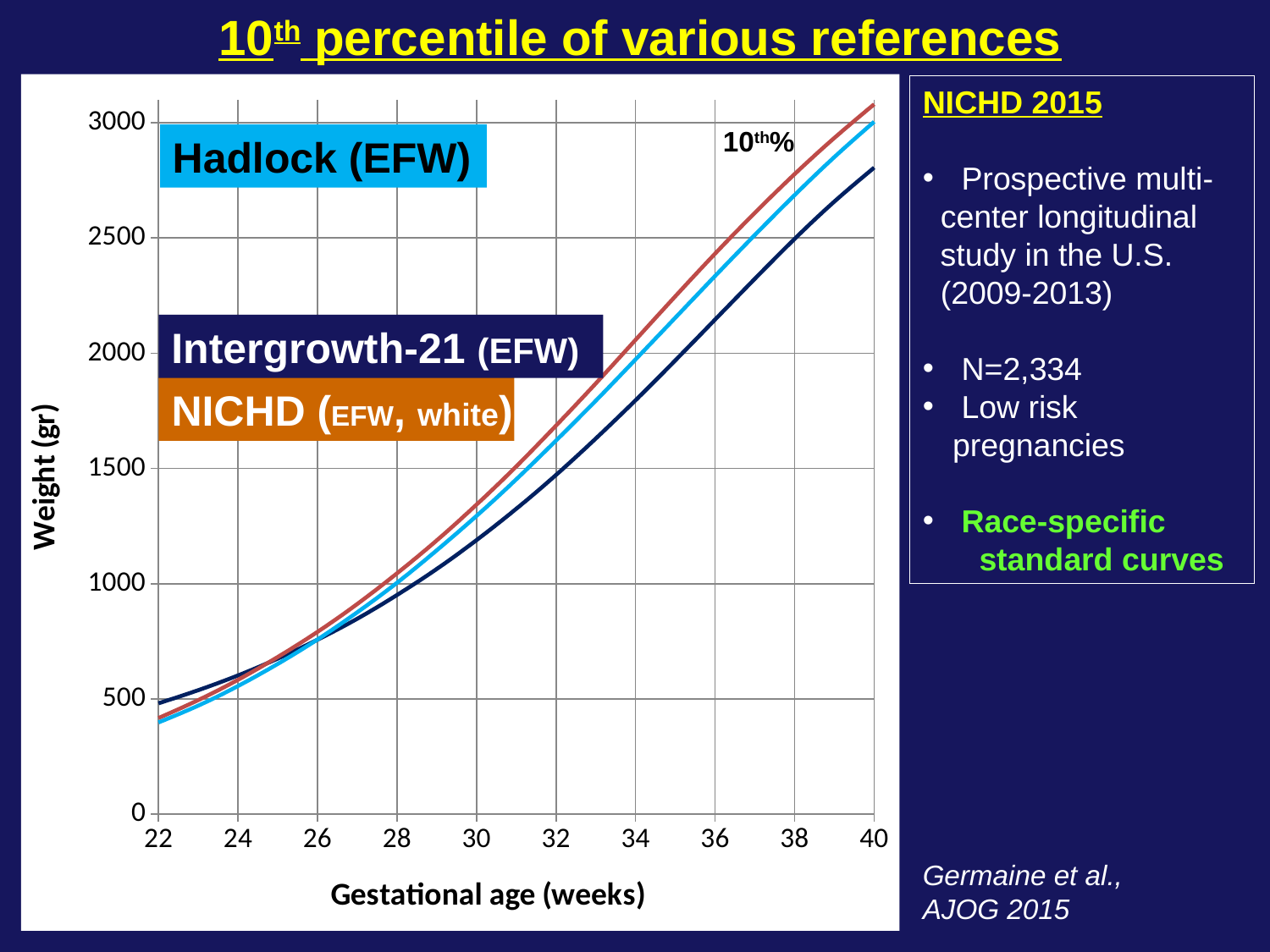
Which reference curve is lowest at 40 weeks? Intergrowth-21 (EFW) Is the Intergrowth-21 (EFW) value at 40 weeks greater or less than 3000? less What is the label of the x axis? Gestational age (weeks) At 40 weeks, which is larger: the NICHD (EFW, white) value or the Intergrowth-21 (EFW) value? NICHD (EFW, white) Do the curves rise or fall as gestational age increases? Rise Which reference curve is highest at 22 weeks? Intergrowth-21 (EFW) What is the label of the y axis? Weight (gr) What kind of chart is shown on the slide? Line chart Is the Hadlock (EFW) value at 22 weeks greater or less than 500? less Which reference curve is highest at 40 weeks? NICHD (EFW, white) How many reference curves are plotted on the chart? 3 Is the Intergrowth-21 (EFW) value at 30 weeks greater or less than 1500? less